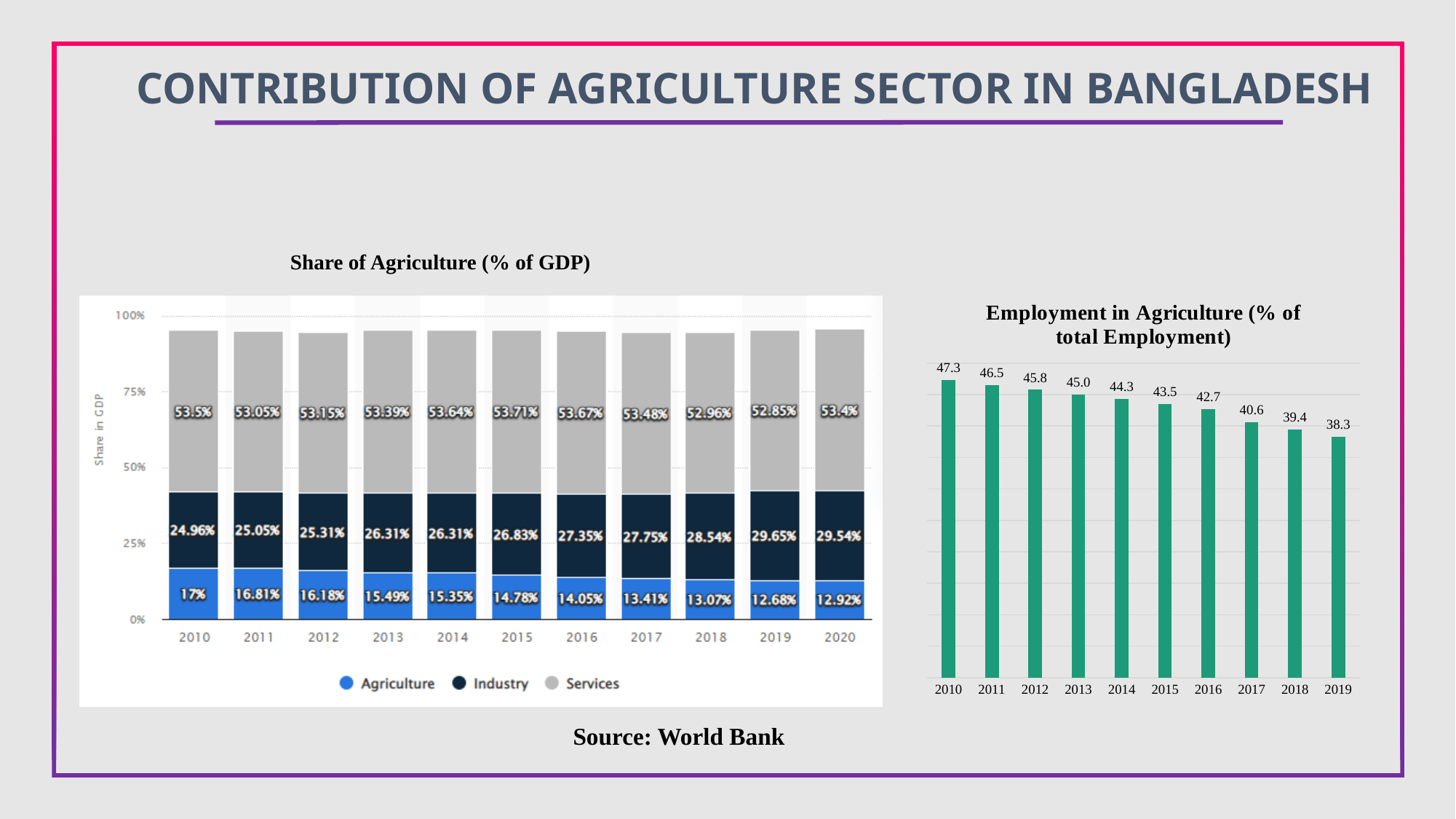
In the 'Share of Agriculture (% of GDP)' chart, which year has the lowest Agriculture share? 2019 In the 'Share of Agriculture (% of GDP)' chart, what is the Industry value for 2020? 29.54% In the 'Share of Agriculture (% of GDP)' chart, does the Agriculture share generally rise or fall from 2010 to 2020? fall In the 'Employment in Agriculture (% of total Employment)' chart, what is the value for 2016? 42.7 In the 'Employment in Agriculture (% of total Employment)' chart, which year has the highest value? 2010 In the 'Share of Agriculture (% of GDP)' chart, how many series does the legend list? 3 What kind of chart is the 'Employment in Agriculture (% of total Employment)' chart? bar chart In the 'Share of Agriculture (% of GDP)' chart, what is the Services value for 2015? 53.71% In the 'Employment in Agriculture (% of total Employment)' chart, what is the difference between the 2010 and 2019 values? 9.0 In the 'Share of Agriculture (% of GDP)' chart, what is the difference between the Industry values for 2020 and 2010? 4.58% In the 'Share of Agriculture (% of GDP)' chart, what is the Agriculture value for 2010? 17% In the 'Employment in Agriculture (% of total Employment)' chart, how many years are shown? 10